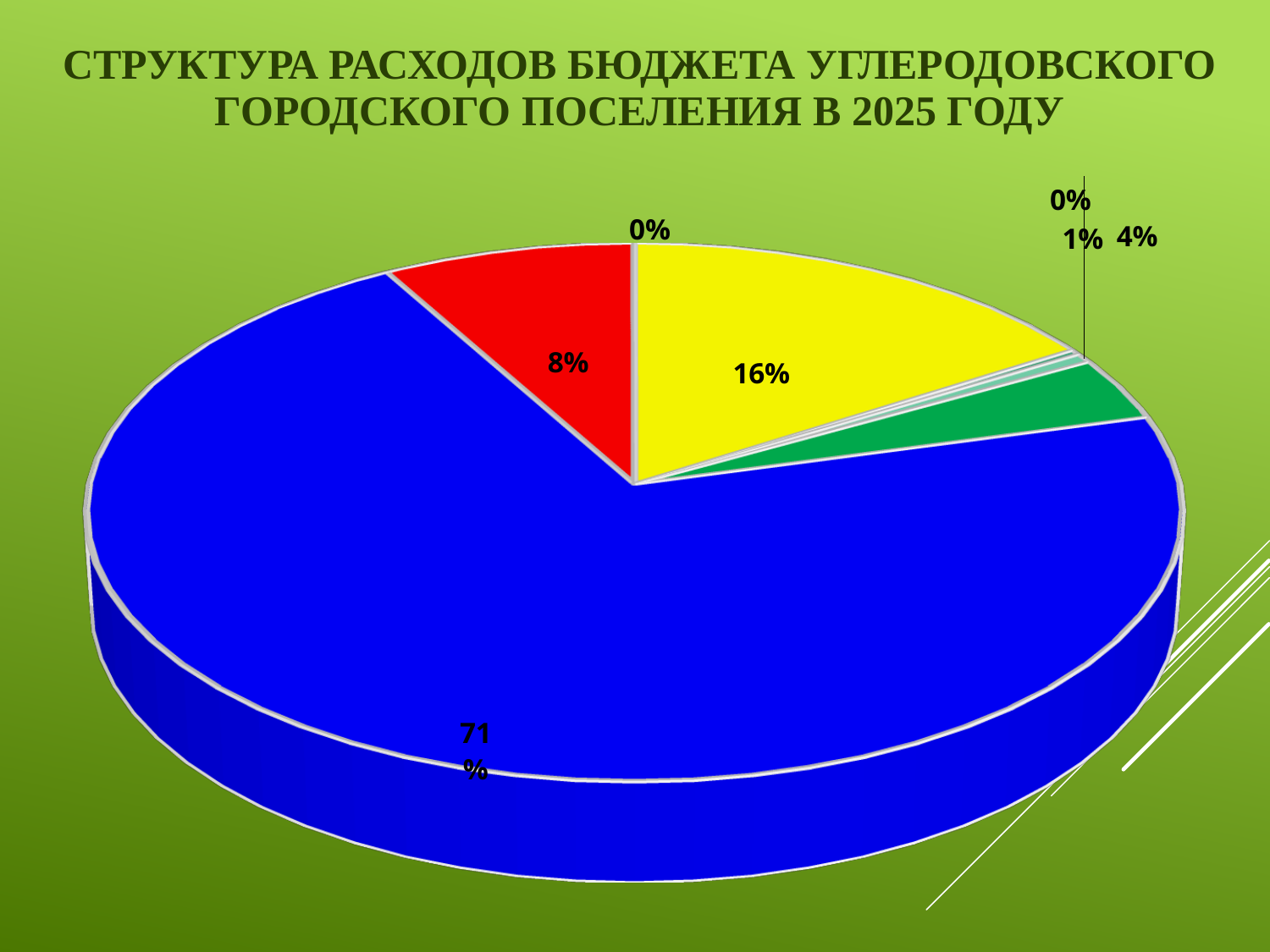
What percentage is shown for the yellow slice of the pie? 16% How many percentage data labels are shown on the pie chart? 7 What is the largest percentage shown on the pie chart? 71% Which colour slice has the largest share of the pie? blue Which is larger, the yellow slice or the red slice? yellow slice What percentage is shown for the blue slice of the pie? 71% What kind of chart is shown on the slide? pie chart What percentage is shown for the red slice of the pie? 8% What is the title of the chart on the slide? СТРУКТУРА РАСХОДОВ БЮДЖЕТА УГЛЕРОДОВСКОГО ГОРОДСКОГО ПОСЕЛЕНИЯ В 2025 ГОДУ What is the difference in percentage points between the blue slice (71%) and the yellow slice (16%)? 55 What percentage is shown for the green slice of the pie? 4% What is the smallest percentage value labelled on the pie chart? 0%